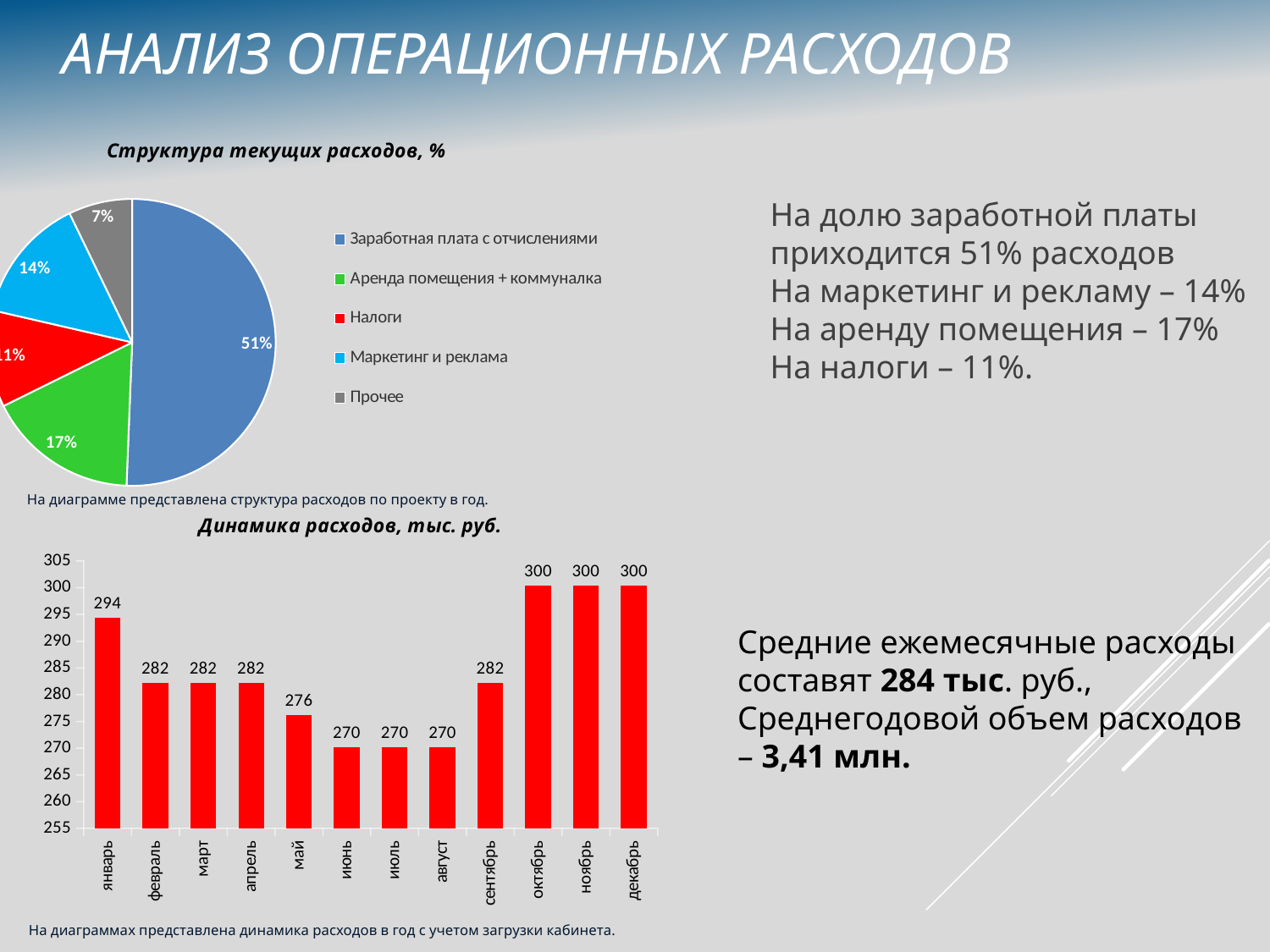
In the bar chart 'Динамика расходов, тыс. руб.', which month has the lowest value? июнь, июль, август (270) In the pie chart 'Структура текущих расходов, %', which category has the smallest share? Прочее In the bar chart 'Динамика расходов, тыс. руб.', how many months are shown on the x axis? 12 In the bar chart 'Динамика расходов, тыс. руб.', what is the value for октябрь? 300 In the pie chart 'Структура текущих расходов, %', what share is 'Маркетинг и реклама'? 14% In the pie chart 'Структура текущих расходов, %', which is larger: 'Аренда помещения + коммуналка' or 'Маркетинг и реклама'? Аренда помещения + коммуналка In the bar chart 'Динамика расходов, тыс. руб.', what is the value for май? 276 What type of chart is 'Динамика расходов, тыс. руб.'? Bar chart In the bar chart 'Динамика расходов, тыс. руб.', what is the value for январь? 294 In the pie chart 'Структура текущих расходов, %', how many categories does the legend list? 5 In the pie chart 'Структура текущих расходов, %', what share is 'Заработная плата с отчислениями'? 51% In the bar chart 'Динамика расходов, тыс. руб.', what is the difference between январь and июнь? 24